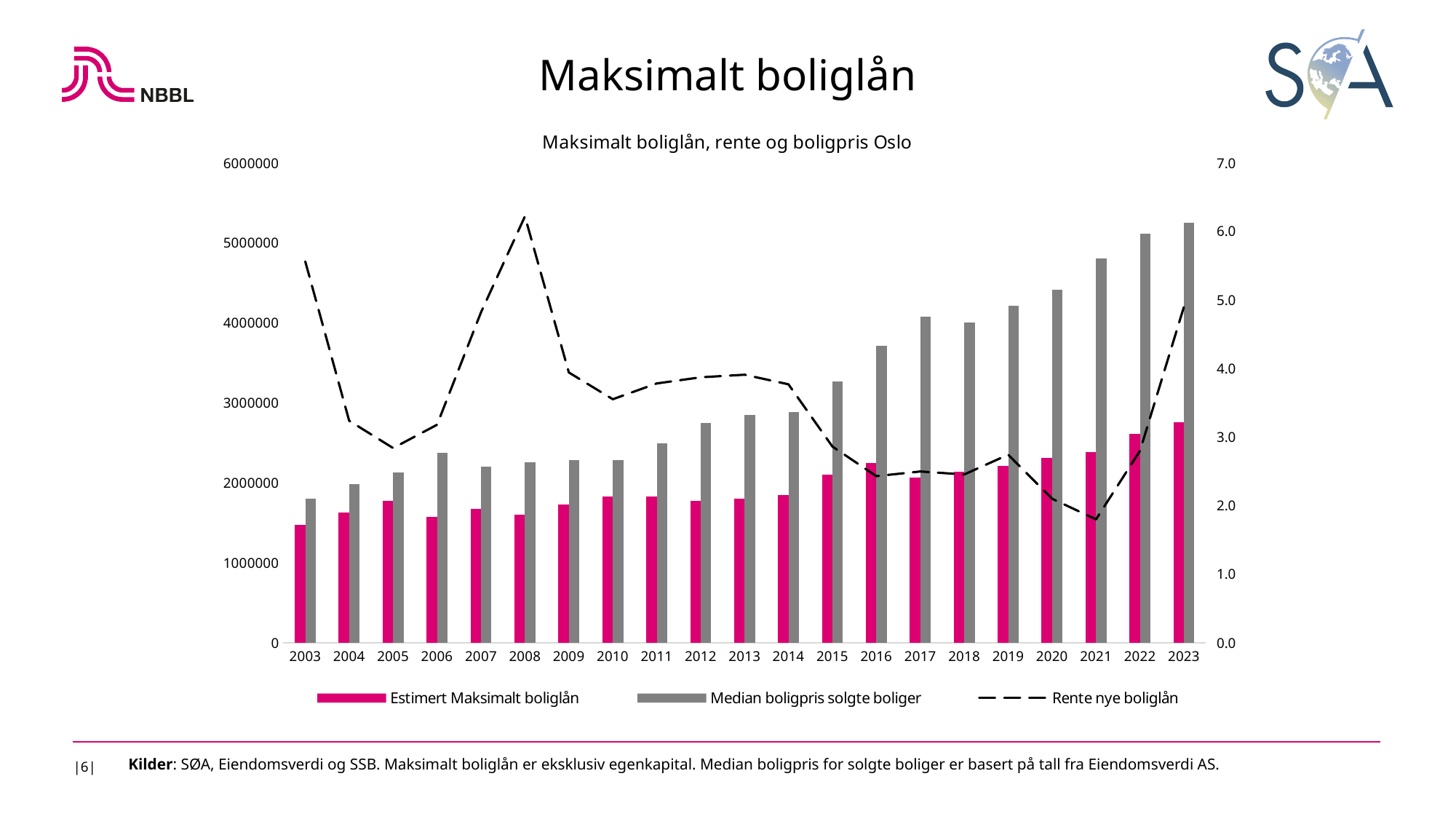
What is the title of the chart? Maksimalt boliglån, rente og boligpris Oslo In which year does Rente nye boliglån reach its highest point? 2008 How many series does the legend list? 3 Is the value for Median boligpris solgte boliger in 2023 greater or less than 5000000? greater Is the value for Rente nye boliglån in 2021 greater or less than 2.0? less In which year is Rente nye boliglån at its lowest? 2021 Does Median boligpris solgte boliger generally rise or fall from 2003 to 2023? rise What kind of chart is this? Combination bar and line chart Is the value for Estimert Maksimalt boliglån in 2023 greater or less than 3000000? less Which year has the highest value for Median boligpris solgte boliger? 2023 How many years are shown on the x axis? 21 Which year has the lowest value for Estimert Maksimalt boliglån? 2003